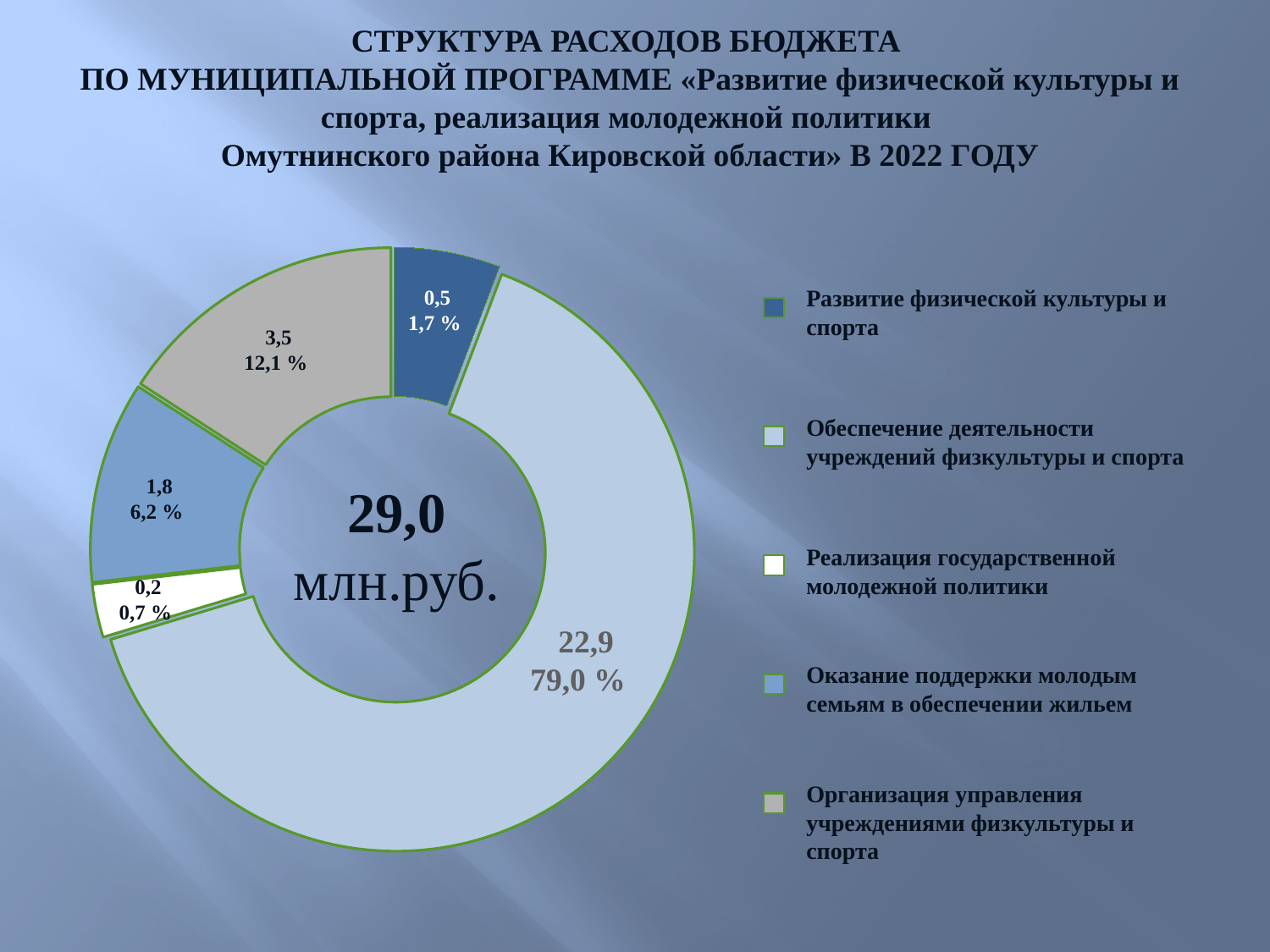
На сколько млн.руб. расходы на «Организацию управления учреждениями физкультуры и спорта» больше расходов на «Оказание поддержки молодым семьям в обеспечении жильем»? 1,7 Какой тип диаграммы показан на слайде? кольцевая (круговая) диаграмма Какая категория имеет наименьшее значение расходов? Реализация государственной молодежной политики Что больше: расходы на «Развитие физической культуры и спорта» или на «Реализацию государственной молодежной политики»? Развитие физической культуры и спорта Какое значение (млн.руб.) приходится на «Оказание поддержки молодым семьям в обеспечении жильем»? 1,8 Какая доля расходов приходится на «Организацию управления учреждениями физкультуры и спорта»? 12,1 % Каким цветом на диаграмме обозначена «Реализация государственной молодежной политики»? белым Какая категория имеет наибольшее значение расходов? Обеспечение деятельности учреждений физкультуры и спорта Какое значение (млн.руб.) приходится на «Обеспечение деятельности учреждений физкультуры и спорта»? 22,9 Какая общая сумма расходов указана в центре диаграммы? 29,0 млн.руб. Какая доля расходов приходится на «Развитие физической культуры и спорта»? 1,7 % Сколько категорий (секторов) показано на диаграмме? 5